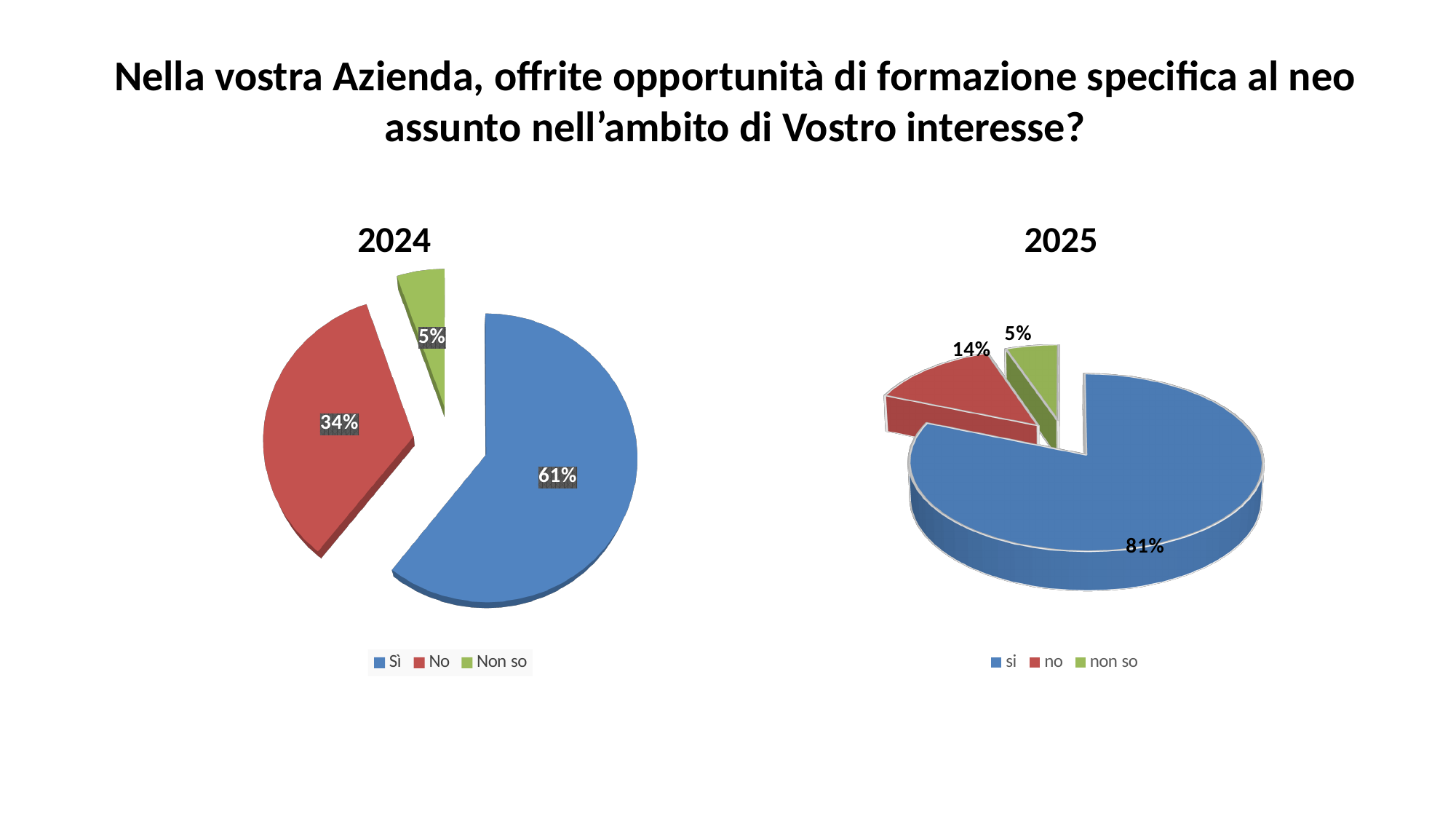
In the 2025 chart, which answer has the smallest share? non so What is the difference between the "Sì" share in the 2024 chart and the "si" share in the 2025 chart? 20 percentage points Which is larger: the "No" share in the 2024 chart or the "no" share in the 2025 chart? 2024 No In the 2025 chart, what percentage of respondents answered "si"? 81% In the 2024 chart, what is the difference between the "Sì" and "No" shares? 27 percentage points In the 2025 chart, what percentage of respondents answered "no"? 14% In the 2024 chart, which answer has the largest share? Sì What type of chart is used for the 2024 and 2025 data? Pie chart In the 2024 chart, what percentage of respondents answered "Sì"? 61% In the 2024 chart, which answer has the smallest share? Non so In the 2024 chart, what percentage of respondents answered "No"? 34% In the 2025 chart, what percentage of respondents answered "non so"? 5%